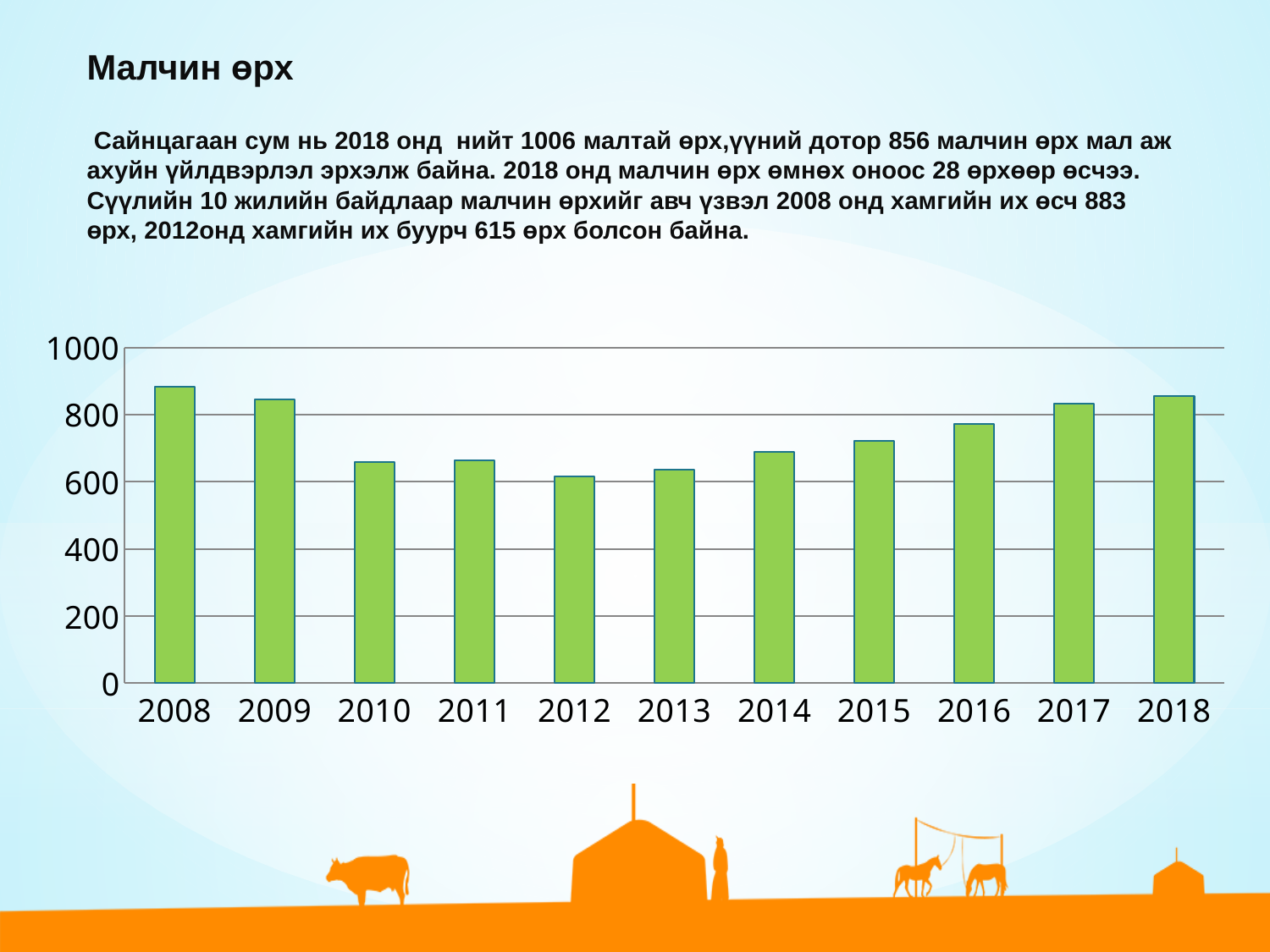
Which year has the highest bar in the chart? 2008 What kind of chart is shown on the slide? bar chart Is the value for 2017 greater or less than 800? greater How many years are shown on the x axis of the chart? 11 What is the difference between the 2008 value and the 2012 value? 268 Which year has the lowest bar in the chart? 2012 What is the number of herder households in 2012? 615 What is the number of herder households in 2018? 856 Which is larger, the value for 2009 or the value for 2010? 2009 What is the number of herder households in 2008? 883 Do the values rise or fall from 2012 to 2018? rise Is the value for 2016 greater or less than 800? less